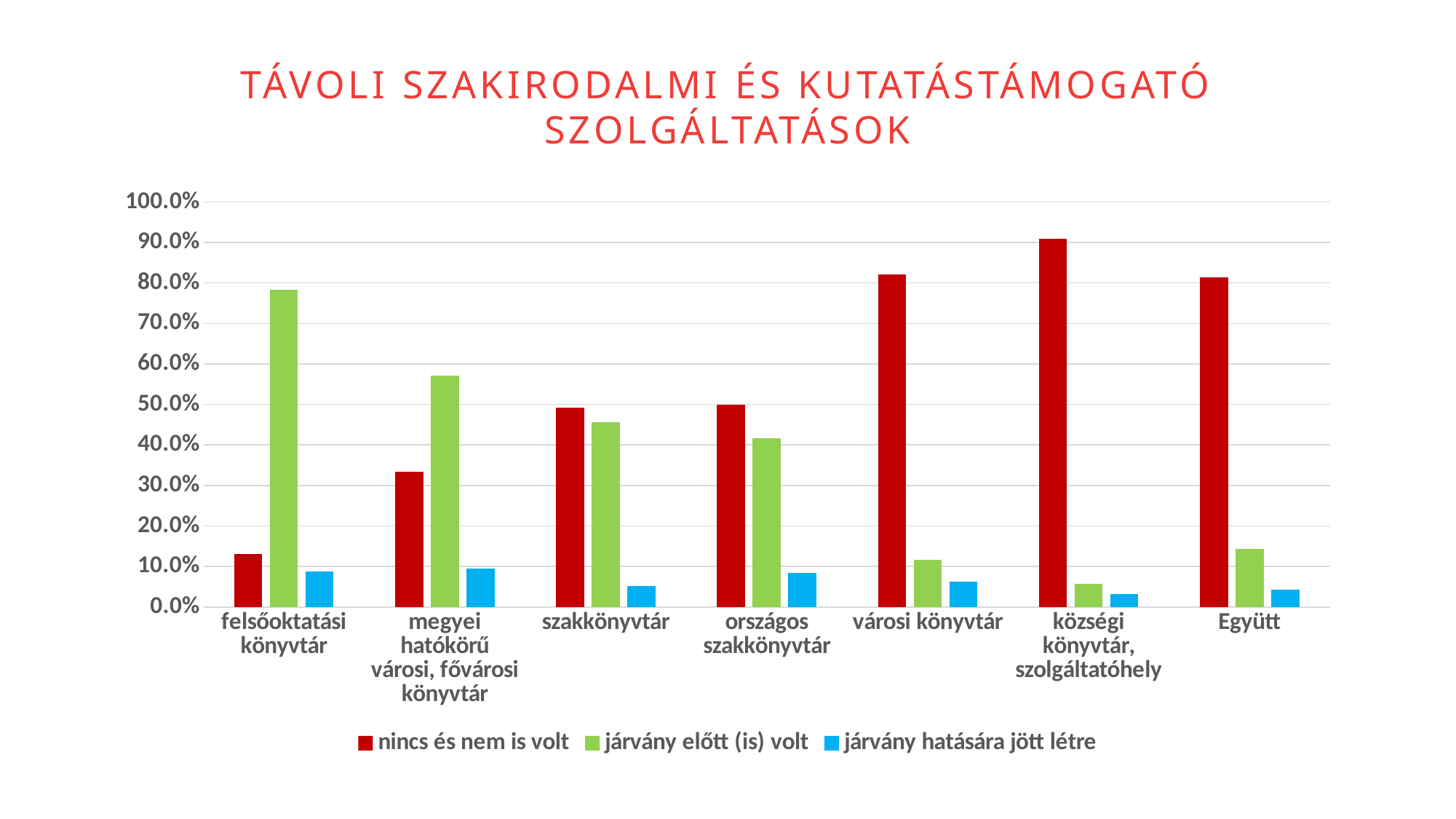
What is the title of the chart? TÁVOLI SZAKIRODALMI ÉS KUTATÁSTÁMOGATÓ SZOLGÁLTATÁSOK Which category has the lowest value for 'járvány előtt (is) volt'? községi könyvtár, szolgáltatóhely Which category has the lowest value for 'nincs és nem is volt'? felsőoktatási könyvtár Is the value for 'nincs és nem is volt' at községi könyvtár, szolgáltatóhely greater or less than 80.0%? greater How many series does the legend list? 3 What kind of chart is shown on the slide? bar chart Is the value for 'járvány előtt (is) volt' at felsőoktatási könyvtár greater or less than 70.0%? greater How many library categories are shown on the x axis? 7 Is the value for 'járvány előtt (is) volt' at Együtt greater or less than 20.0%? less Which category has the highest value for 'nincs és nem is volt'? községi könyvtár, szolgáltatóhely Which category has the highest value for 'járvány előtt (is) volt'? felsőoktatási könyvtár For megyei hatókörű városi, fővárosi könyvtár, which is larger: 'nincs és nem is volt' or 'járvány előtt (is) volt'? járvány előtt (is) volt